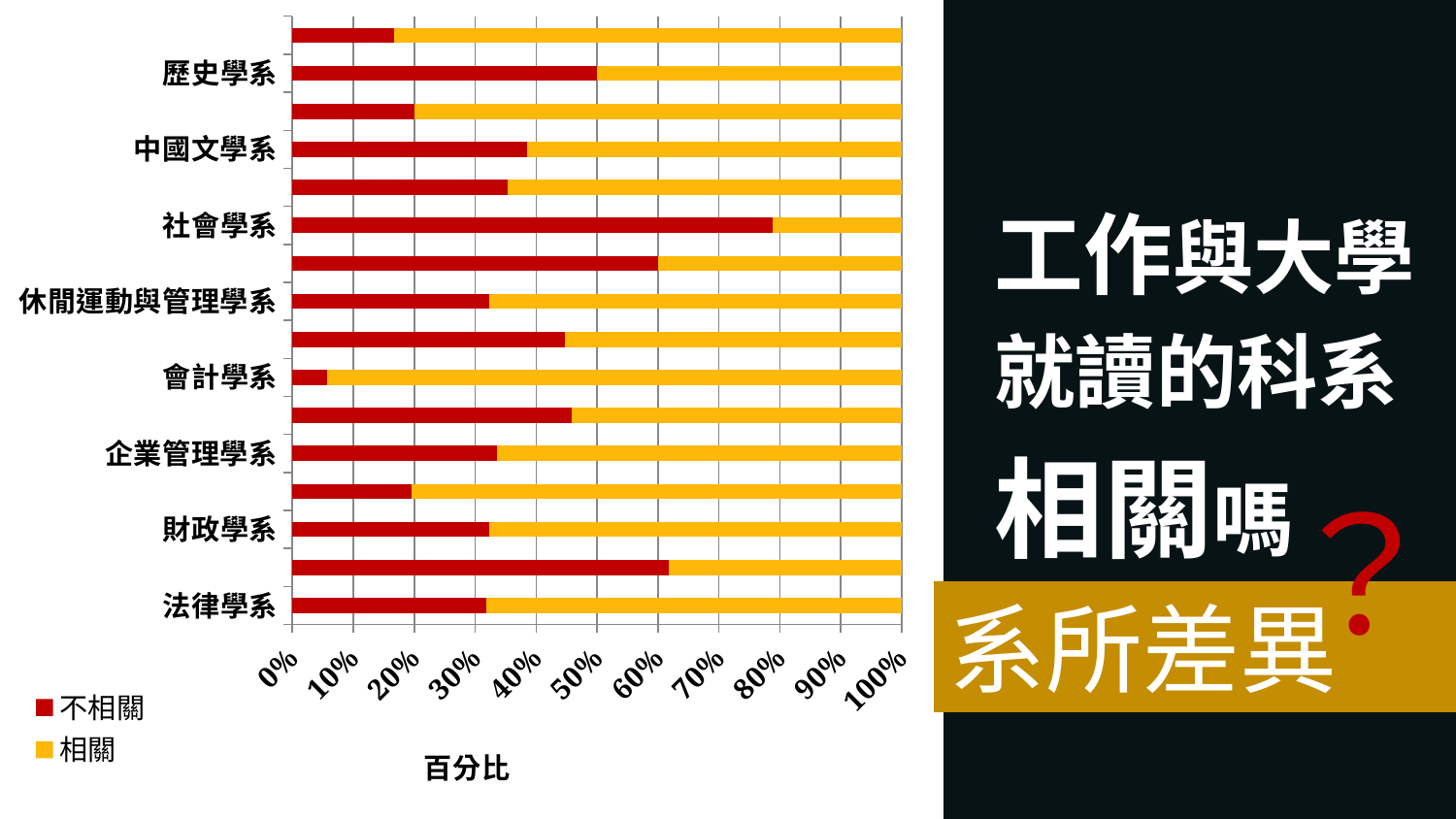
Which labeled department has the smallest 不相關 share? 會計學系 Which labeled department has the largest 不相關 share? 社會學系 Which has a larger 不相關 share, 社會學系 or 法律學系? 社會學系 What is the title of the horizontal axis? 百分比 Is the 不相關 value for 中國文學系 greater or less than 30%? greater What are the two series named in the legend? 不相關 and 相關 Is the 不相關 value for 社會學系 greater or less than 70%? greater Which labeled department has the largest 相關 share? 會計學系 What percentage does each stacked bar total at its right end? 100% Is the 不相關 value for 會計學系 greater or less than 10%? less What kind of chart is shown on the slide? Stacked bar chart How many series does the legend list? 2